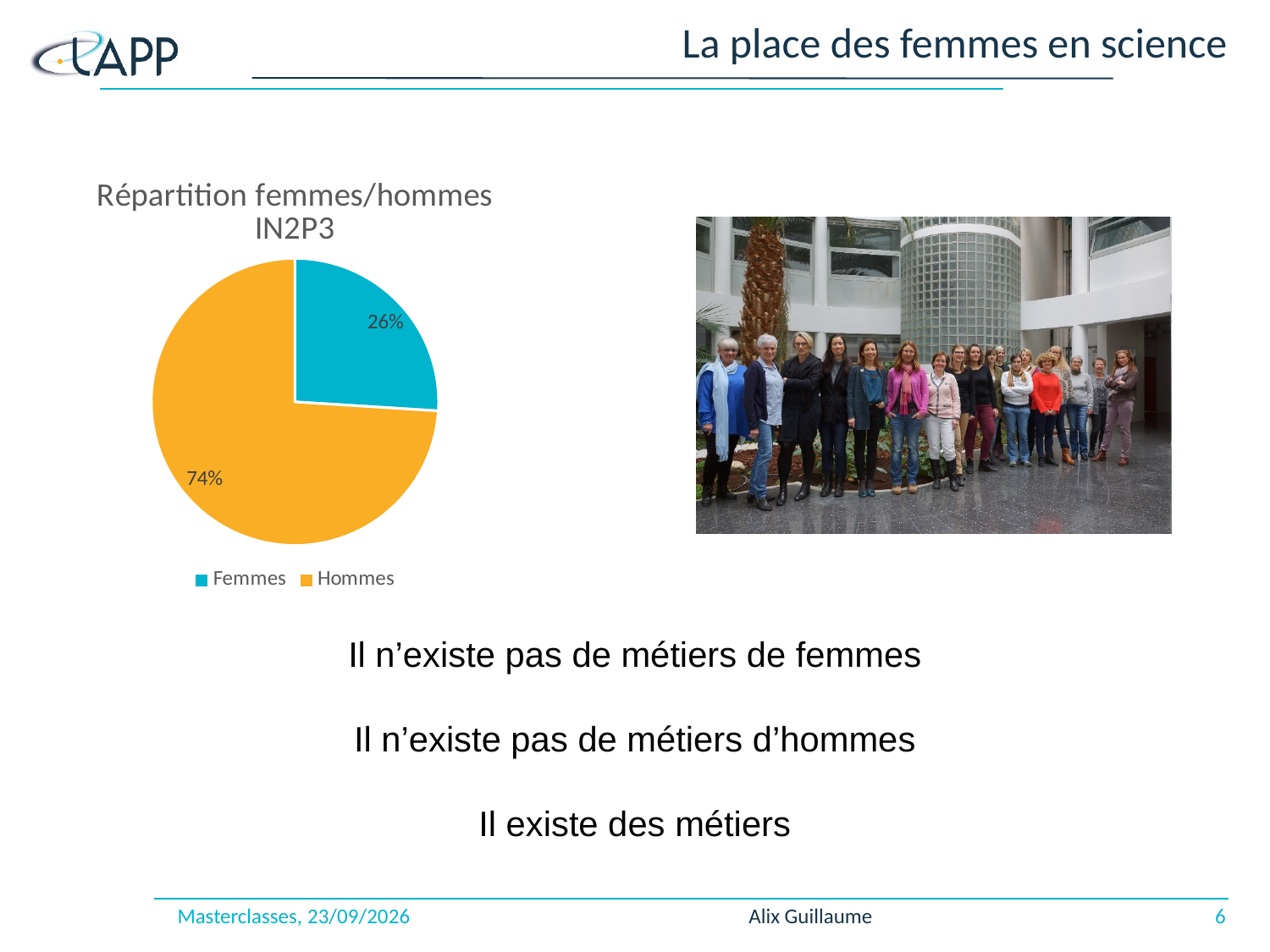
Which share is larger, Femmes or Hommes? Hommes What is the share of the pie for Femmes? 26% What percentage of the pie is labelled for Femmes? 26% How many categories does the pie chart have? 2 What colour is the Femmes slice? blue Which category has the smallest share of the pie? Femmes What percentage of the pie is labelled for Hommes? 74% What is the title of the chart? Répartition femmes/hommes IN2P3 What is the difference in percentage points between the Hommes and Femmes shares? 48 How many entries does the legend list? 2 What kind of chart is shown on the slide? pie chart Which category has the largest share of the pie? Hommes